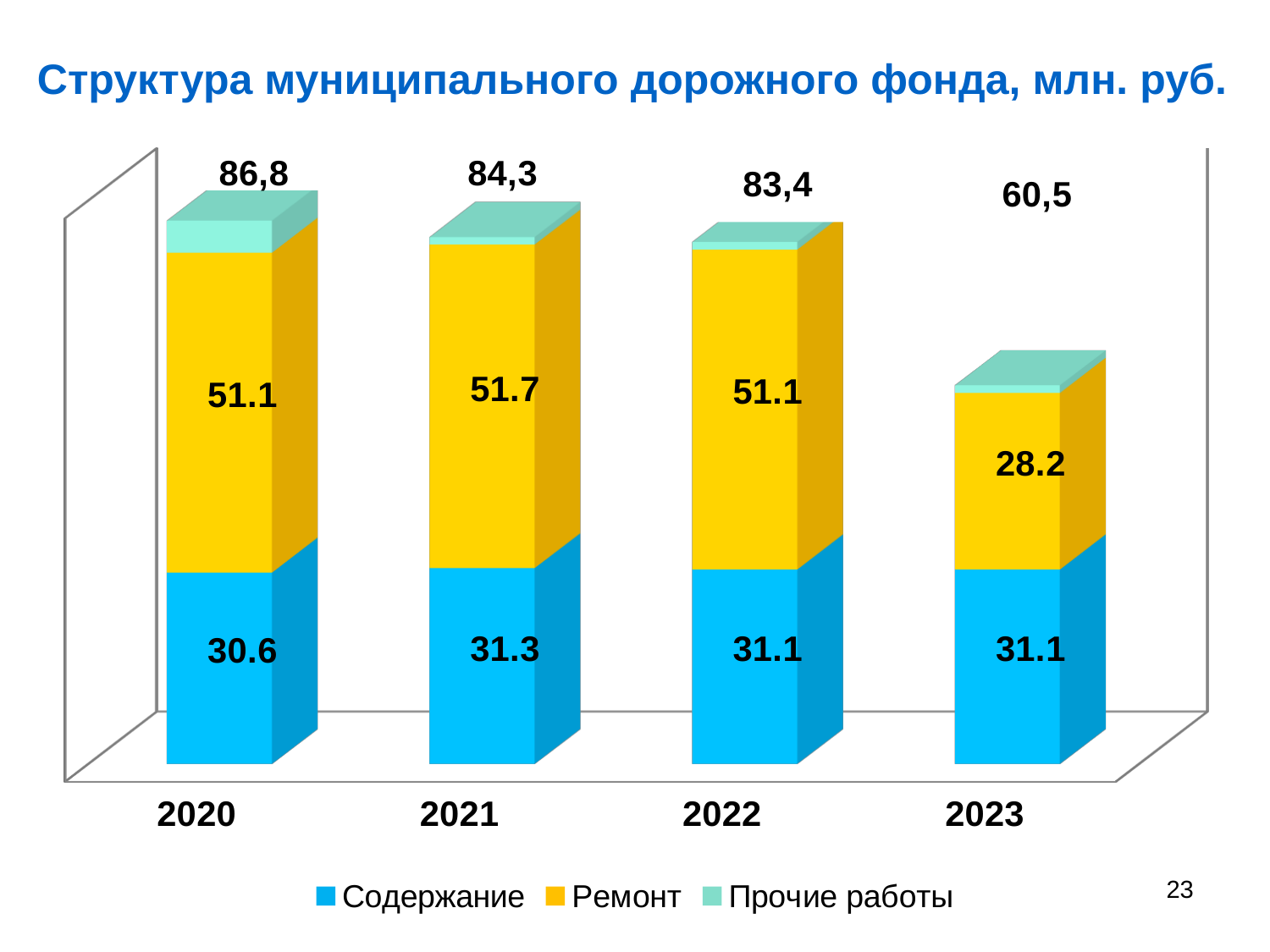
In 2022, which is larger: Ремонт or Содержание? Ремонт Which year has the highest total value? 2020 How many series does the legend list? 3 How many years are shown on the x axis? 4 Do the total values rise or fall from 2020 to 2023? Fall What is the title of the chart? Структура муниципального дорожного фонда, млн. руб. What is the difference between the Ремонт values for 2021 and 2023? 23.5 What is the value of Содержание for 2020? 30.6 What is the value of Ремонт for 2021? 51.7 What is the total shown above the bar for 2023? 60,5 Which year has the lowest value for Ремонт? 2023 What kind of chart is shown on the slide? Stacked bar chart